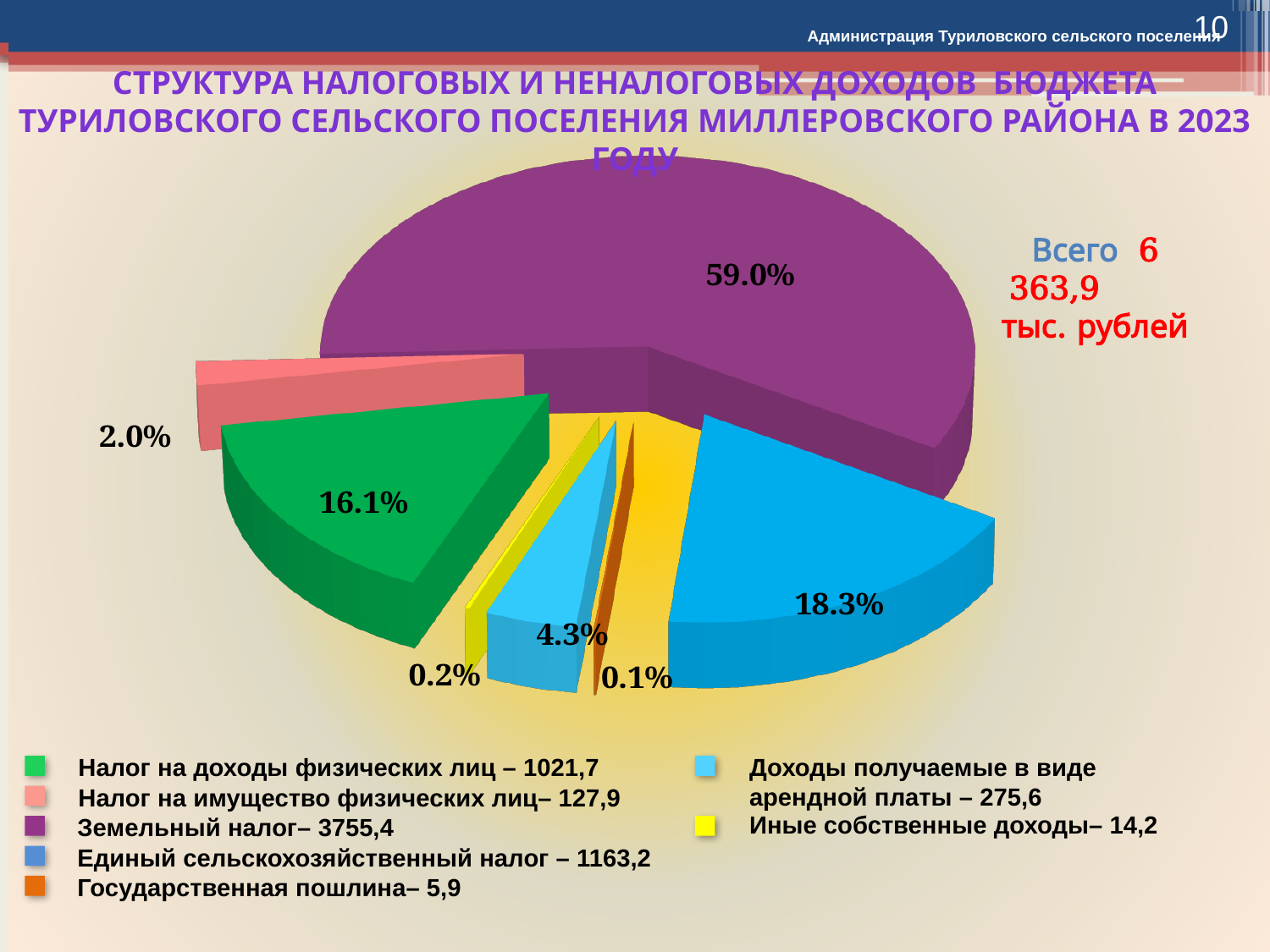
What share of the pie does the largest slice (Земельный налог) represent? 59.0% Which category has the largest share of the pie? Земельный налог How many slices does the pie chart have? 7 What is the value given in the legend for Доходы получаемые в виде арендной платы? 275,6 What kind of chart is shown on the slide? pie chart What percentage is shown for the blue slice (Единый сельскохозяйственный налог)? 18.3% Which category has the smallest share of the pie? Государственная пошлина What percentage is shown for the green slice (Налог на доходы физических лиц)? 16.1% What total amount is stated on the slide next to the pie chart? 6 363,9 тыс. рублей Which is larger: the share for Налог на доходы физических лиц or the share for Единый сельскохозяйственный налог? Единый сельскохозяйственный налог What is the difference in percentage points between the 59.0% slice and the 18.3% slice? 40.7 What is the value given in the legend for Налог на имущество физических лиц? 127,9